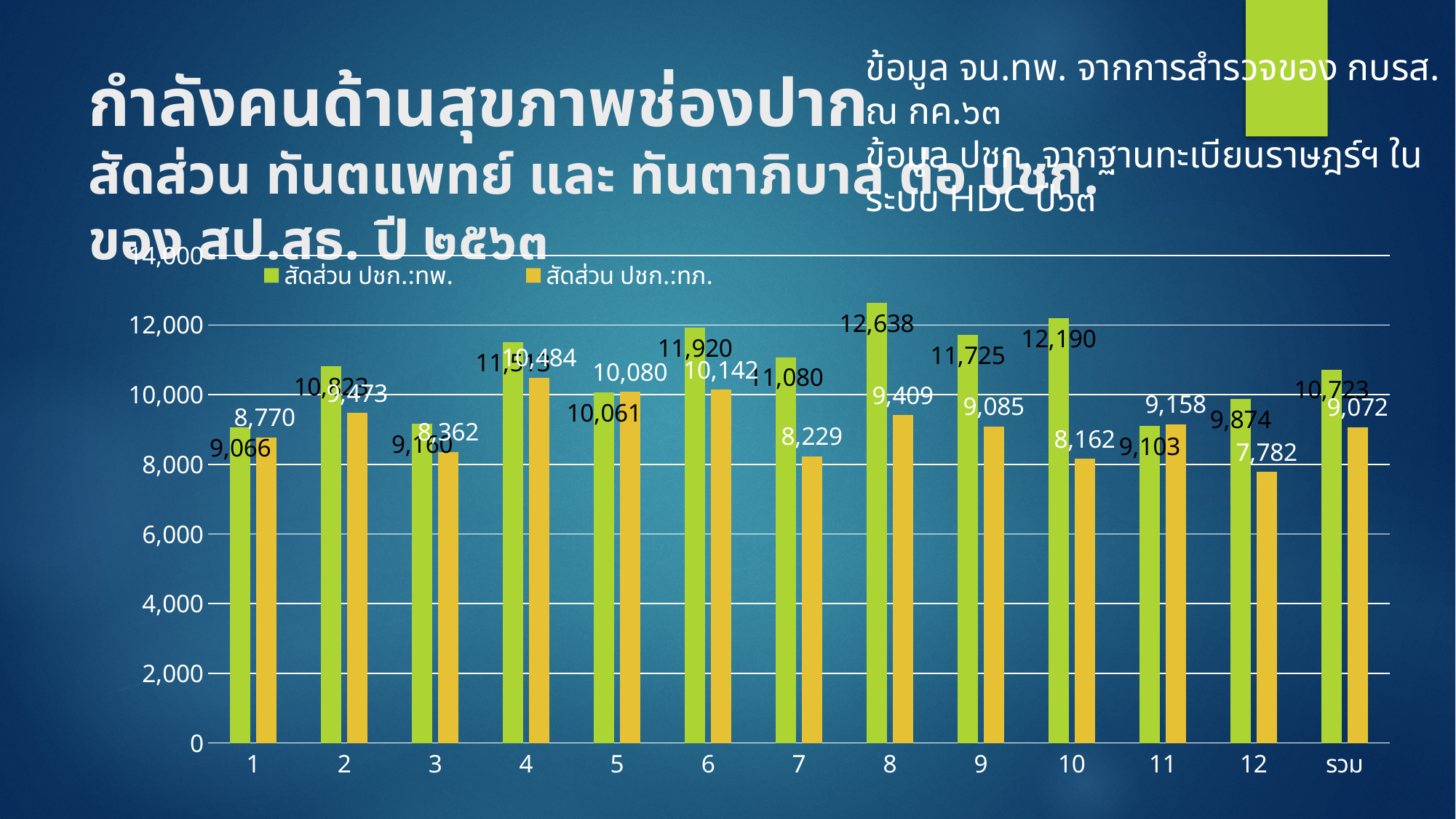
What is the value of สัดส่วน ปชก.:ทพ. for category 8? 12,638 For category 7, which series has the larger value, สัดส่วน ปชก.:ทพ. or สัดส่วน ปชก.:ทภ.? สัดส่วน ปชก.:ทพ. Is the value of สัดส่วน ปชก.:ทภ. for category 4 greater or less than 10,000? greater Which colour represents สัดส่วน ปชก.:ทภ. in the legend? yellow What kind of chart is shown on the slide? bar chart What is the value of สัดส่วน ปชก.:ทพ. for รวม? 10,723 What is the difference between สัดส่วน ปชก.:ทพ. and สัดส่วน ปชก.:ทภ. for category 10? 4,028 How many categories are shown along the x axis? 13 Which category has the highest value for สัดส่วน ปชก.:ทพ.? 8 Which category has the lowest value for สัดส่วน ปชก.:ทภ.? 12 What is the value of สัดส่วน ปชก.:ทภ. for category 12? 7,782 How many series does the legend list? 2